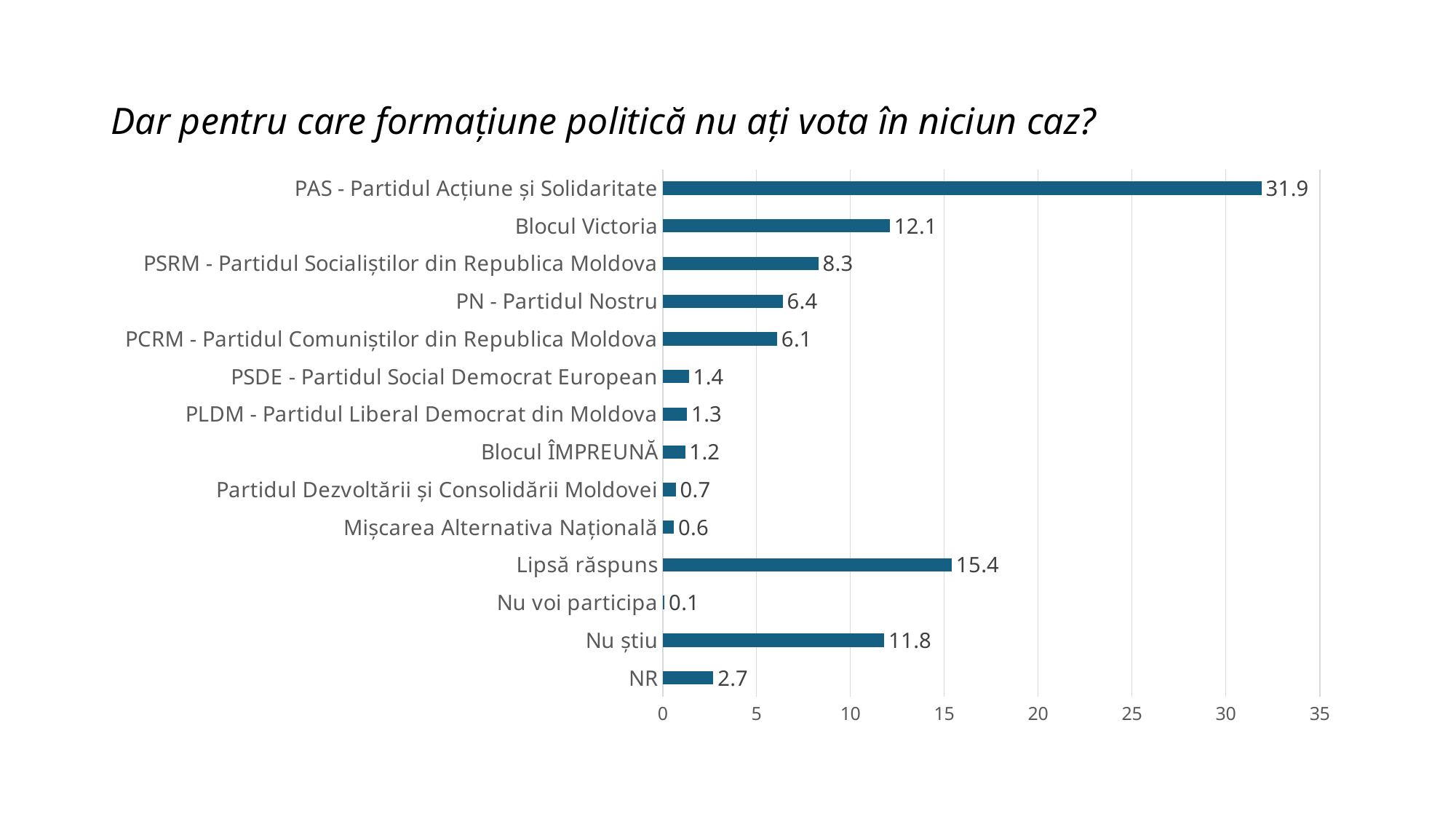
What is the title of the slide? Dar pentru care formațiune politică nu ați vota în niciun caz? Which category has the highest value? PAS - Partidul Acțiune și Solidaritate What is the value for PAS - Partidul Acțiune și Solidaritate? 31.9 What kind of chart is shown on the slide? bar chart What is the value for Lipsă răspuns? 15.4 What is the value for Blocul Victoria? 12.1 What is the difference between the values for PAS - Partidul Acțiune și Solidaritate and Blocul Victoria? 19.8 Is the value for Lipsă răspuns greater or less than 15? greater Which is larger, the value for PSRM - Partidul Socialiștilor din Republica Moldova or the value for PN - Partidul Nostru? PSRM - Partidul Socialiștilor din Republica Moldova What is the value for Nu știu? 11.8 How many categories are shown in the chart? 14 Which category has the lowest value? Nu voi participa